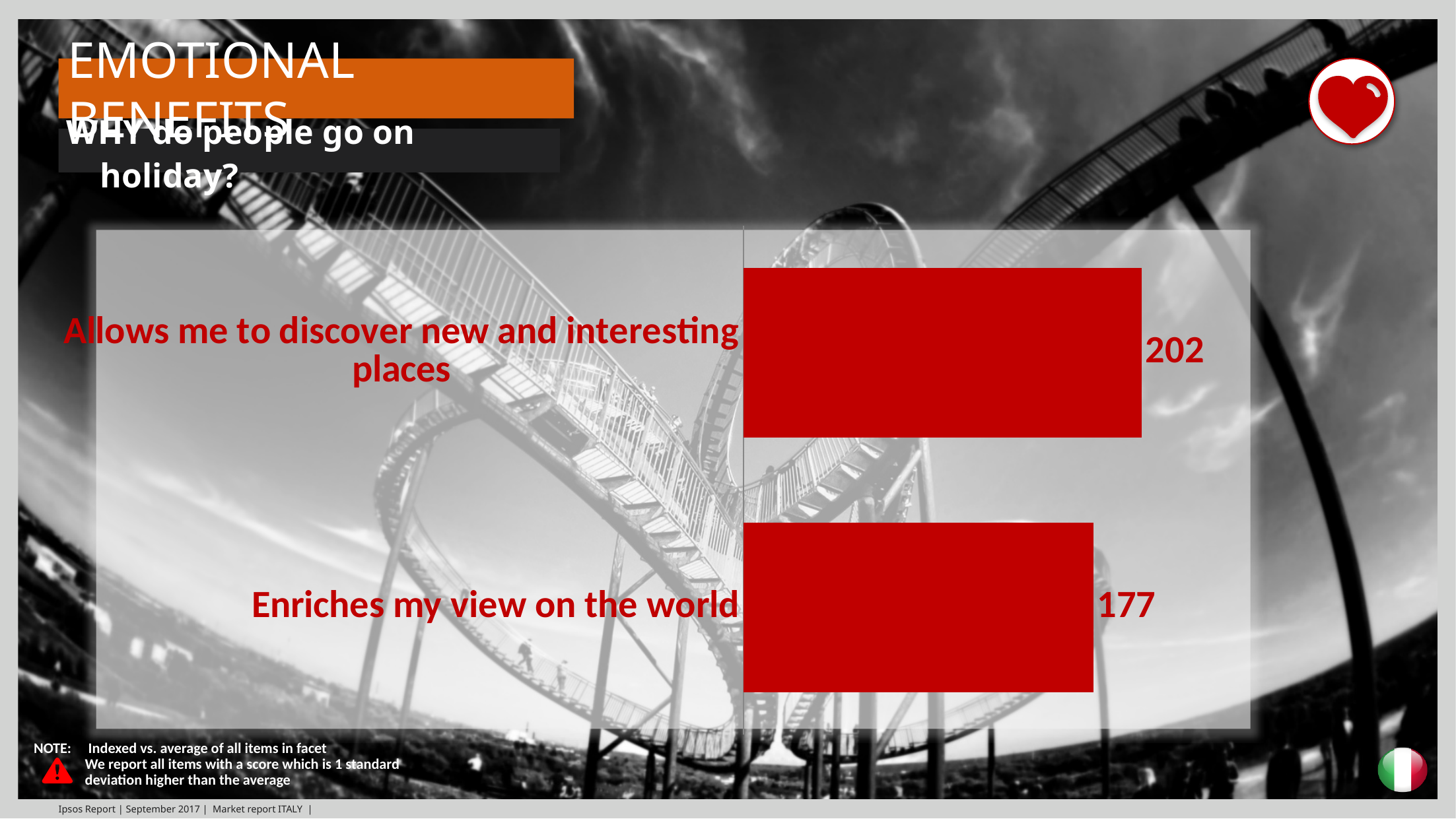
What is the value for "Enriches my view on the world"? 177 How many categories are shown in the chart? 2 Which is larger: the value for "Enriches my view on the world" or the value for "Allows me to discover new and interesting places"? Allows me to discover new and interesting places Which category has the lowest value? Enriches my view on the world What colour are the bars in the chart? Red What is the value for "Allows me to discover new and interesting places"? 202 What is the difference between the values for "Allows me to discover new and interesting places" and "Enriches my view on the world"? 25 Which category has the highest value? Allows me to discover new and interesting places Are the bars in the chart horizontal or vertical? Horizontal What kind of chart is shown on the slide? Bar chart